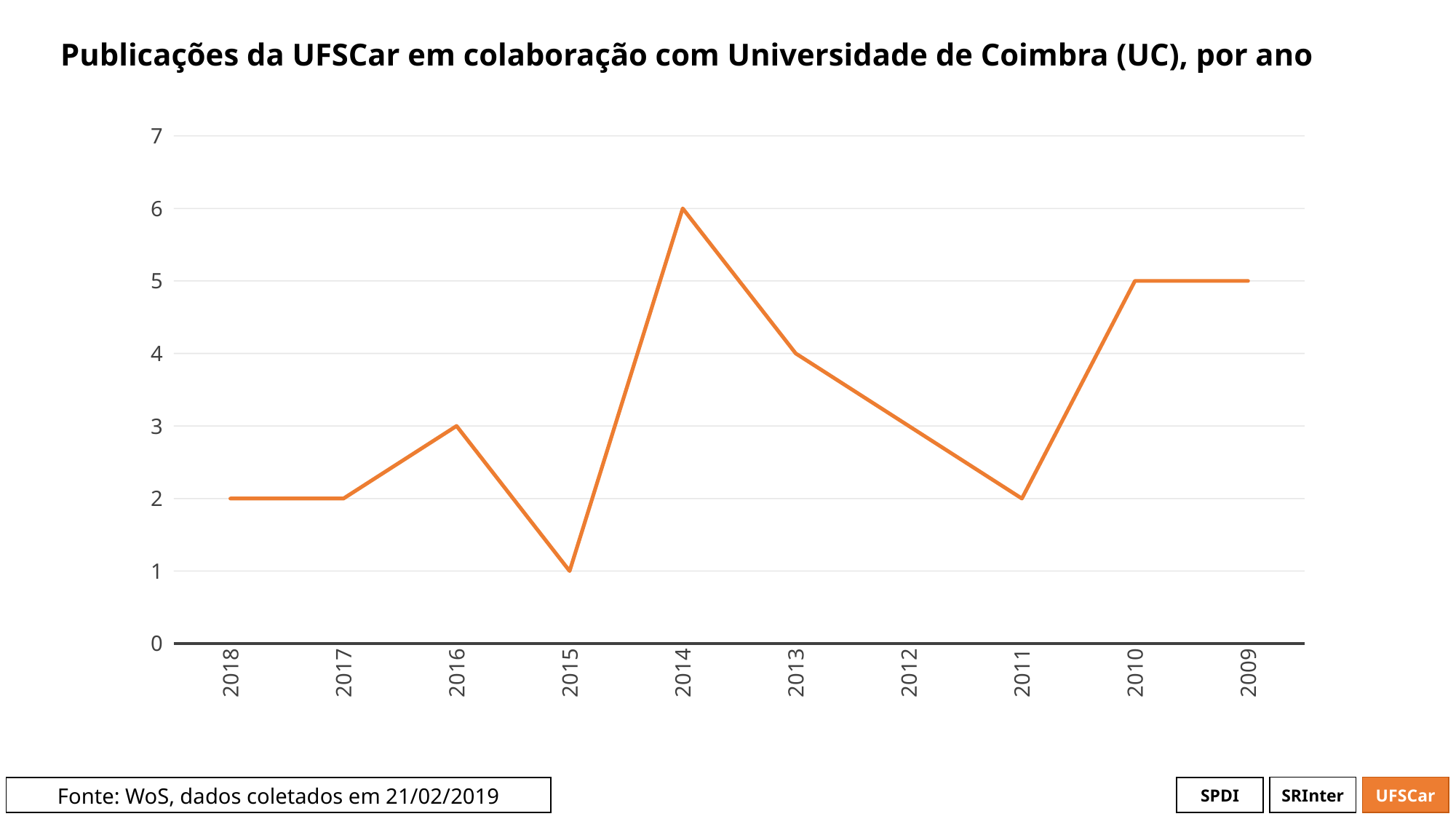
What is the difference between the values for 2014 and 2015? 5 What is the value for 2015? 1 What is the value for 2016? 3 What is the value for 2010? 5 Is the value for 2009 greater or less than 4? greater Which is larger, the value for 2013 or the value for 2011? 2013 Which year has the highest value? 2014 What is the title of the chart? Publicações da UFSCar em colaboração com Universidade de Coimbra (UC), por ano Which year has the lowest value? 2015 What kind of chart is shown on the slide? line chart What is the value for 2014? 6 How many years are plotted on the x axis? 10